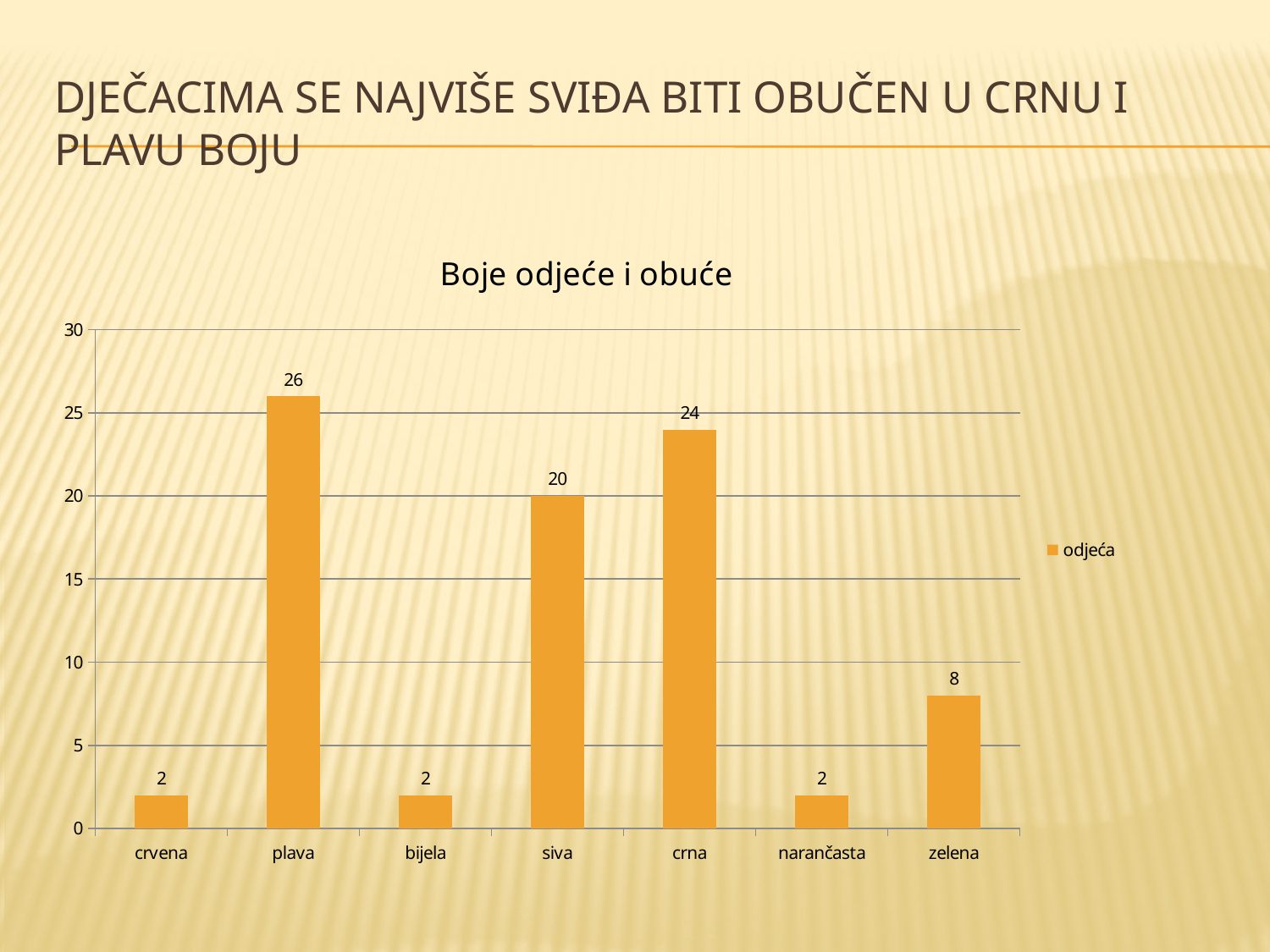
What is the value for zelena? 8 Which is larger, the value for siva or the value for crna? crna What kind of chart is shown? bar chart What is the value for plava? 26 What is the difference between the values for plava and crna? 2 What is the difference between the values for siva and zelena? 12 Is the value for siva greater or less than 15? greater Which category has the highest value? plava How many categories are shown on the x axis? 7 What is the value for crna? 24 How many series does the legend list? 1 What is the title of the chart? Boje odjeće i obuće